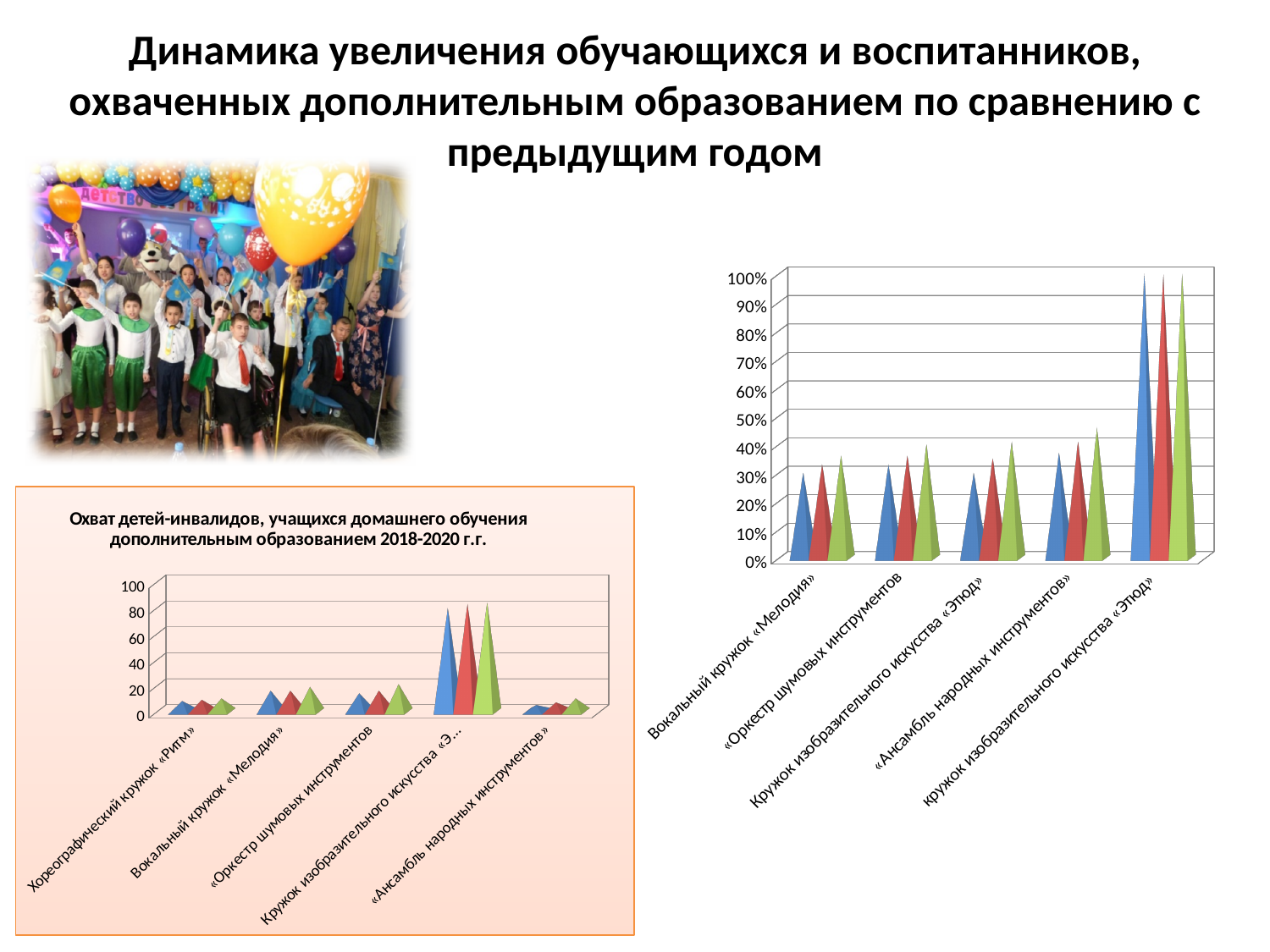
What is the title of the left chart? Охват детей-инвалидов, учащихся домашнего обучения дополнительным образованием 2018-2020 г.г. In the left chart, is the value for Кружок изобразительного искусства greater or less than 60? greater In the right chart, is the value for the last category, кружок изобразительного искусства «Этюд», greater or less than 90%? greater How many categories are shown on the x axis of the left chart? 5 In the left chart, which category has the highest values? Кружок изобразительного искусства How many categories are shown on the x axis of the right chart? 5 In the left chart, which is larger: the value for Кружок изобразительного искусства or the value for Вокальный кружок «Мелодия»? Кружок изобразительного искусства What kind of chart is the left chart titled «Охват детей-инвалидов, учащихся домашнего обучения дополнительным образованием 2018-2020 г.г.»? Bar chart How many bars are plotted for each category in the left chart? 3 In the left chart, is the value for Хореографический кружок «Ритм» greater or less than 20? less What kind of chart is the right chart with the percentage axis? Bar chart